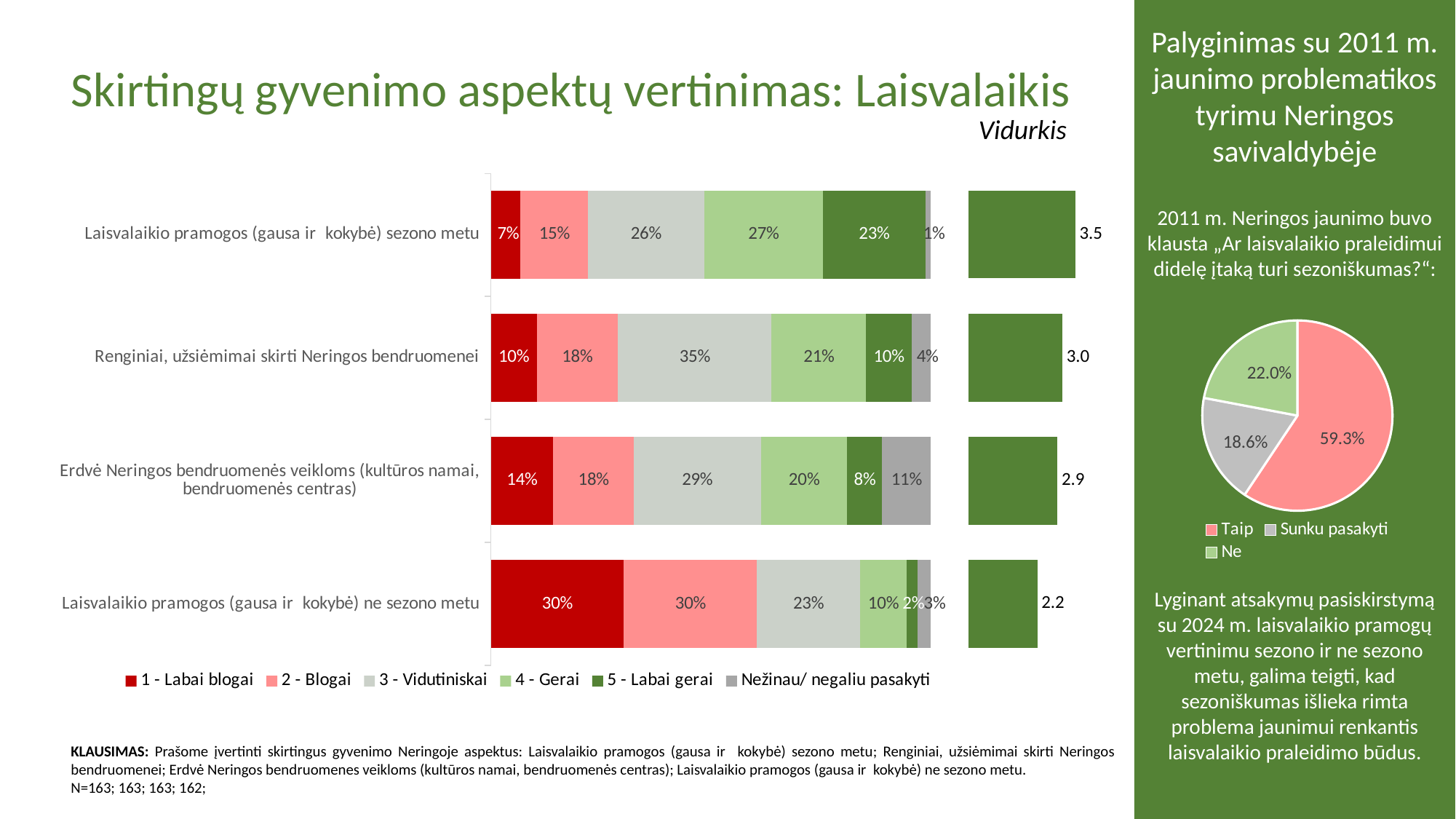
In the stacked bar chart, what is the '3 - Vidutiniskai' share for 'Renginiai, užsiėmimai skirti Neringos bendruomenei'? 35% How many series does the legend of the stacked bar chart list? 6 How many categories are shown in the stacked bar chart? 4 In the stacked bar chart, what percentage of respondents rated 'Laisvalaikio pramogos (gausa ir kokybė) sezono metu' as '5 - Labai gerai'? 23% In the pie chart on the right, what share of respondents answered 'Taip'? 59.3% What kind of chart is shown on the right side of the slide under the 2011 question? Pie chart In the 'Vidurkis' chart, what is the average for 'Renginiai, užsiėmimai skirti Neringos bendruomenei'? 3.0 In the stacked bar chart, what percentage of respondents rated 'Laisvalaikio pramogos (gausa ir kokybė) ne sezono metu' as '1 - Labai blogai'? 30% In the 'Vidurkis' chart, which category has the lowest average? Laisvalaikio pramogos (gausa ir kokybė) ne sezono metu In the 'Vidurkis' chart, what is the difference between the averages for 'Laisvalaikio pramogos (gausa ir kokybė) sezono metu' and 'Laisvalaikio pramogos (gausa ir kokybė) ne sezono metu'? 1.3 In the stacked bar chart, which category has the highest '1 - Labai blogai' share? Laisvalaikio pramogos (gausa ir kokybė) ne sezono metu In the stacked bar chart, what is the difference between the '4 - Gerai' shares for 'Laisvalaikio pramogos (gausa ir kokybė) sezono metu' and 'Erdvė Neringos bendruomenės veikloms (kultūros namai, bendruomenės centras)'? 7%